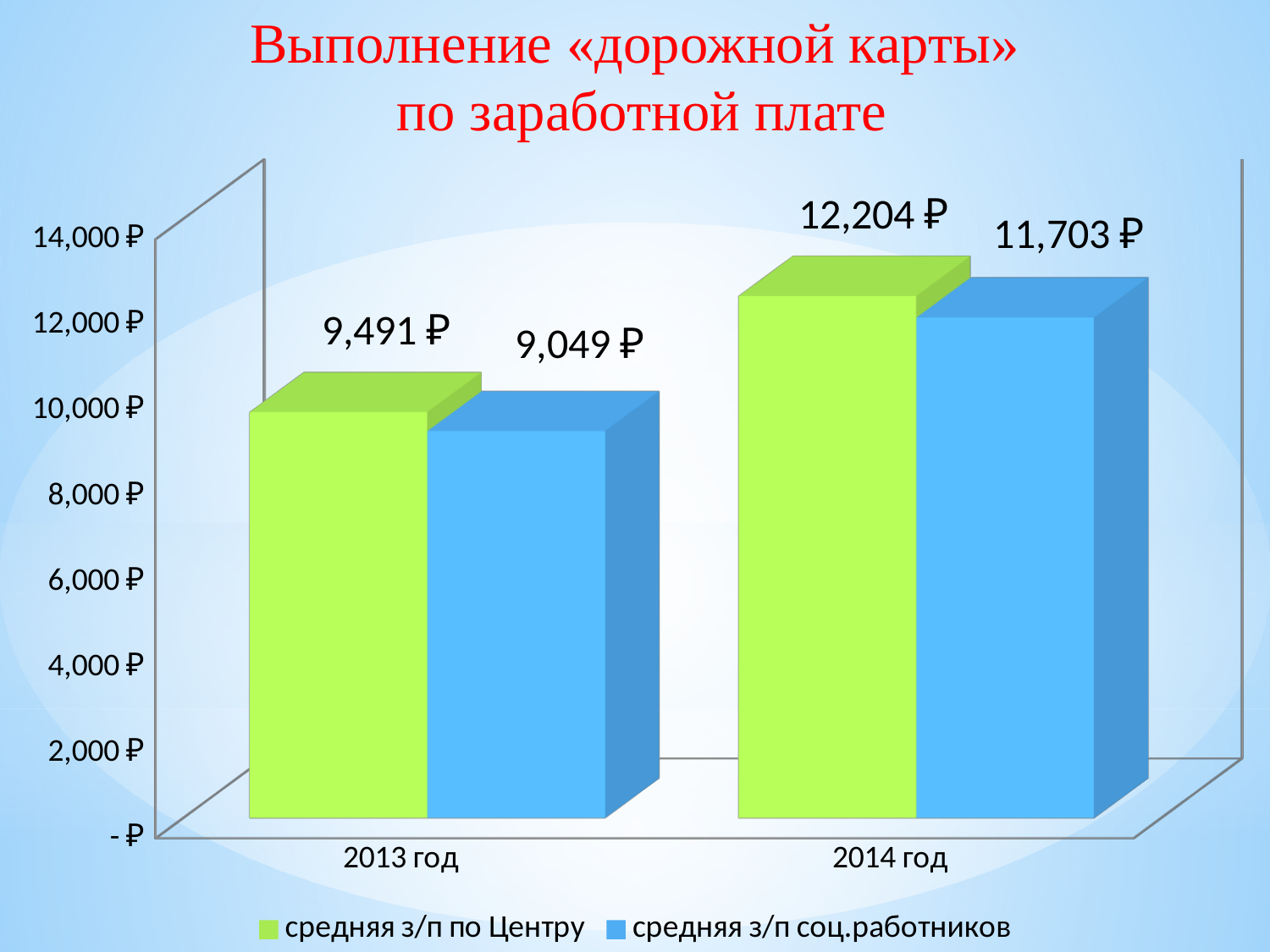
What is the value for средняя з/п соц.работников in 2014 год? 11,703 ₽ What is the value for средняя з/п по Центру in 2013 год? 9,491 ₽ What is the difference between средняя з/п по Центру and средняя з/п соц.работников in 2014 год? 501 ₽ Which bar has the highest value on the chart? средняя з/п по Центру, 2014 год How many series does the legend list? 2 What is the difference between the 2014 год and 2013 год values for средняя з/п соц.работников? 2,654 ₽ Which is larger in 2013 год: средняя з/п по Центру or средняя з/п соц.работников? средняя з/п по Центру What is the value for средняя з/п по Центру in 2014 год? 12,204 ₽ What kind of chart is shown on the slide? bar chart Do the values for средняя з/п по Центру rise or fall from 2013 год to 2014 год? rise Which bar has the lowest value on the chart? средняя з/п соц.работников, 2013 год What is the value for средняя з/п соц.работников in 2013 год? 9,049 ₽